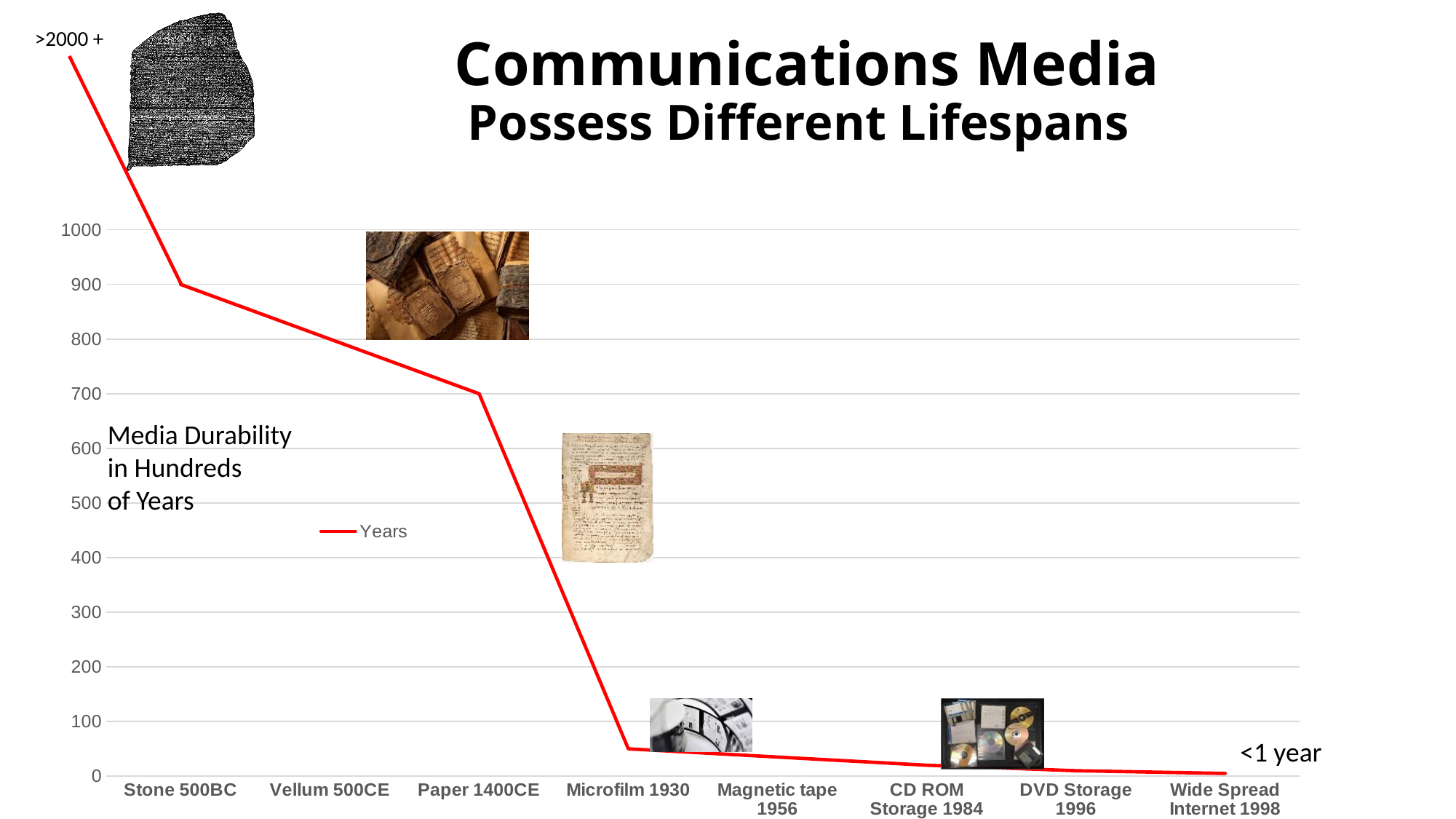
What kind of chart is shown on the slide? line chart Which category has the lowest value? Wide Spread Internet 1998 How many media categories are shown along the x axis? 8 Do the values rise or fall moving left to right along the x axis? fall Is the value for Microfilm 1930 greater or less than 100? less What is the value for Vellum 500CE? 800 What is the name of the series in the legend? Years What is the value for Paper 1400CE? 700 Which category has the highest value? Stone 500BC Which is larger, the value for Vellum 500CE or the value for Paper 1400CE? Vellum 500CE Is the value for Stone 500BC greater or less than 1000? less How many series does the legend list? 1